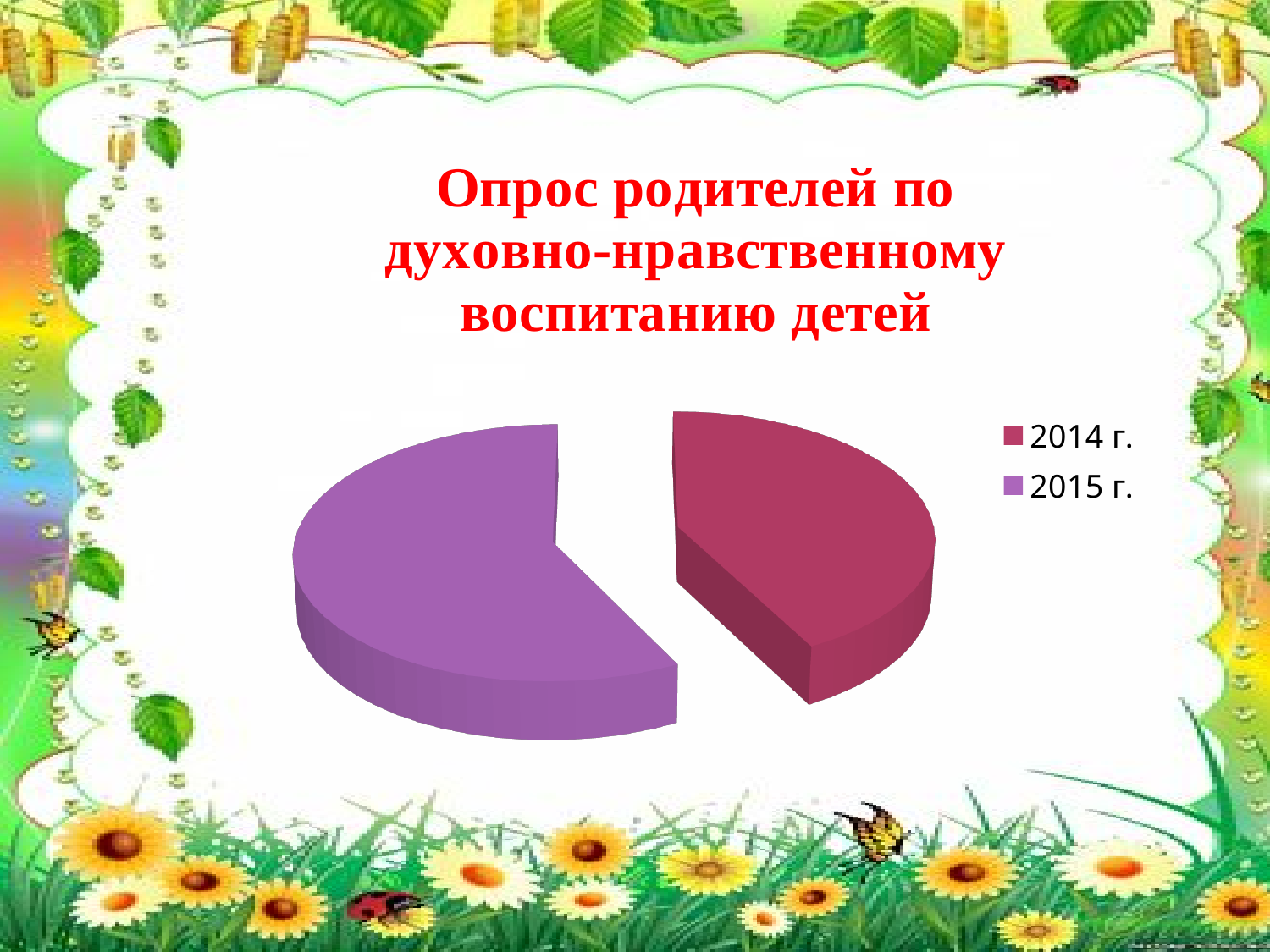
Which slice is larger in the pie chart, 2014 г. or 2015 г.? 2015 г. Which slice of the pie chart is the smallest? 2014 г. Which slice of the pie chart is the largest? 2015 г. What is the title of the chart on the slide? Опрос родителей по духовно-нравственному воспитанию детей How many entries does the legend of the pie chart list? 2 Does the 2015 г. slice take up more or less than half of the pie? More What colour is the 2014 г. slice in the pie chart? Dark pink (magenta) What kind of chart is shown on the slide? Pie chart How many slices does the pie chart have? 2